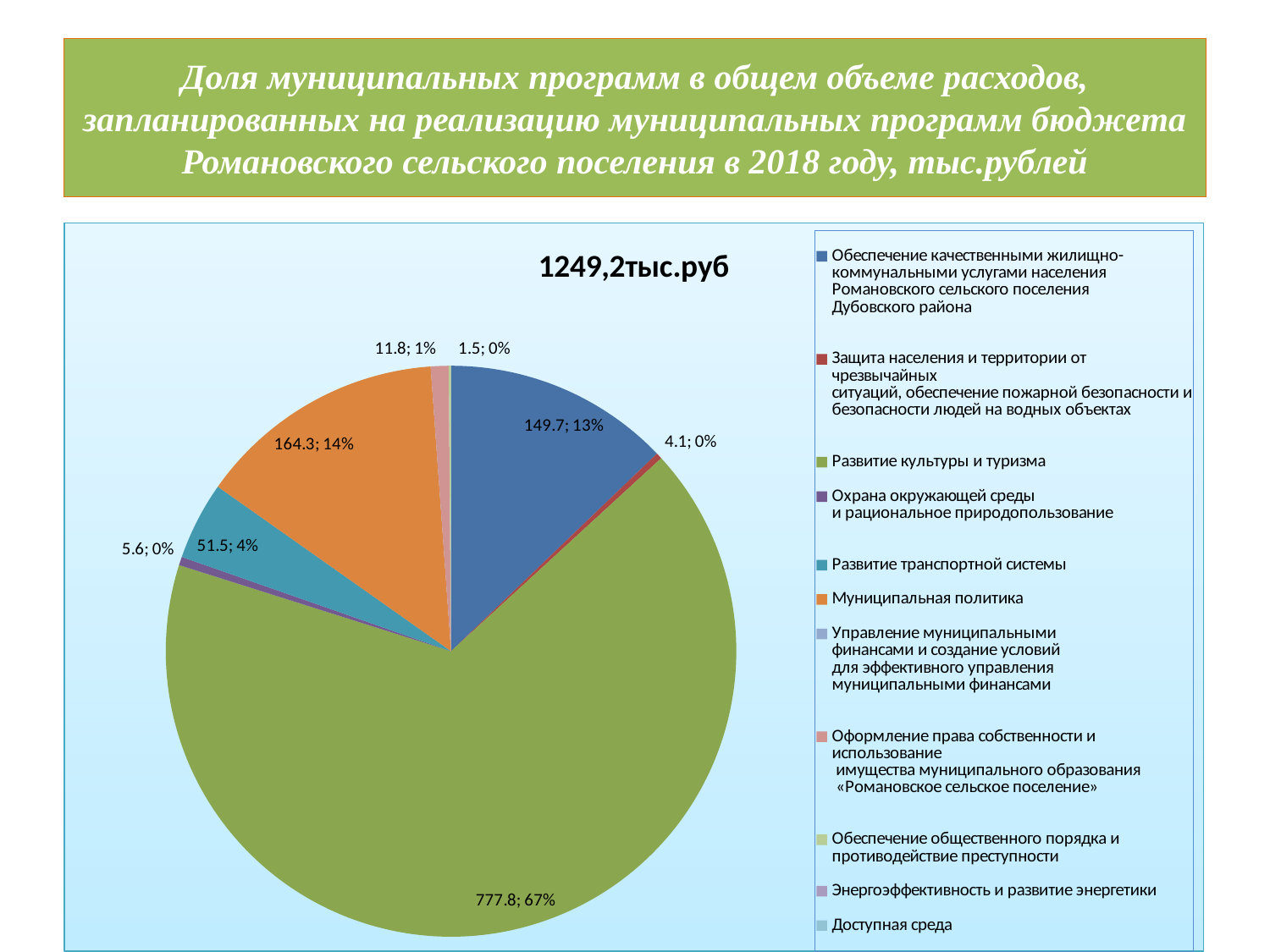
What is the value shown for "Защита населения и территории от чрезвычайных ситуаций, обеспечение пожарной безопасности и безопасности людей на водных объектах"? 4.1 What is the value shown for "Охрана окружающей среды и рациональное природопользование"? 5.6 What share of the pie does "Развитие культуры и туризма" take? 67% What kind of chart is shown on the slide? pie chart What is the value shown for "Муниципальная политика"? 164.3 What total is shown as the title of the pie chart? 1249,2тыс.руб What is the value shown for "Обеспечение качественными жилищно-коммунальными услугами населения Романовского сельского поселения Дубовского района"? 149.7 What is the difference between the values for "Муниципальная политика" and "Обеспечение качественными жилищно-коммунальными услугами населения Романовского сельского поселения Дубовского района"? 14.6 Which is larger: the value for "Муниципальная политика" or for "Обеспечение качественными жилищно-коммунальными услугами населения Романовского сельского поселения Дубовского района"? Муниципальная политика What is the value shown for the slice "Развитие культуры и туризма"? 777.8 What is the value shown for "Развитие транспортной системы"? 51.5 Which category has the largest slice of the pie? Развитие культуры и туризма